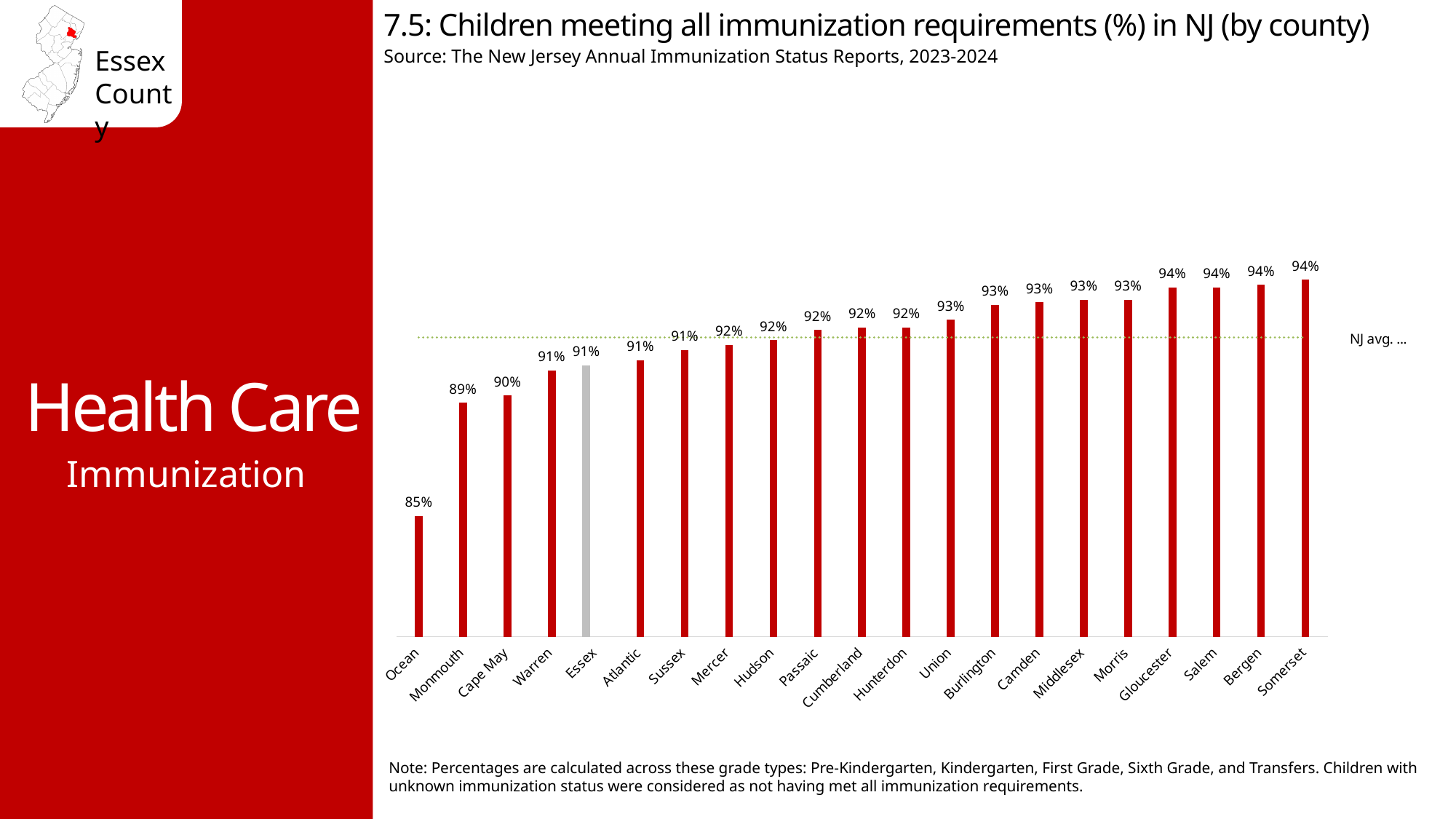
What is the difference between the values for Somerset and Ocean? 9 percentage points What is the value for Union? 93% What is the value for Somerset? 94% How many counties are shown on the chart? 21 What is the value for Ocean? 85% Which is larger, the value for Cape May or the value for Monmouth? Cape May Which county's bar is coloured grey instead of red? Essex What kind of chart is shown on the slide? bar chart What is the value for Essex? 91% Do the values rise or fall moving from left to right along the x axis? rise Which county has the lowest percentage of children meeting all immunization requirements? Ocean What is the value for Monmouth? 89%